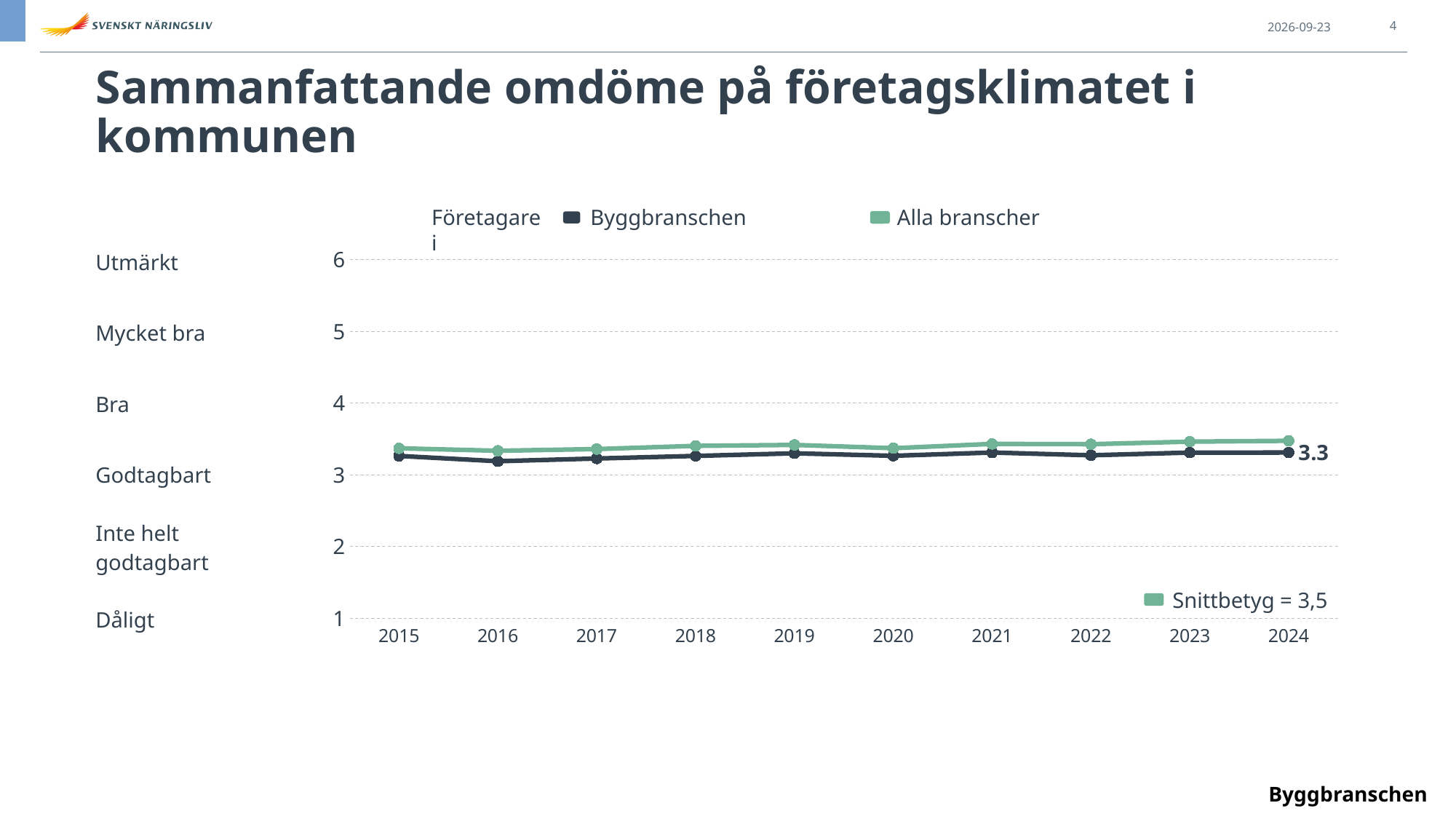
In 2016, which series has the higher value, Byggbranschen or Alla branscher? Alla branscher Is the value for Byggbranschen in 2024 greater or less than 3? greater What is the value of the Byggbranschen series in 2024? 3.3 How many years are shown on the x axis of the chart? 10 How many series does the chart legend list? 2 In 2024, which series has the higher value, Byggbranschen or Alla branscher? Alla branscher What is the Snittbetyg value shown on the chart? 3,5 Is the value for Alla branscher in 2015 greater or less than 4? less Which rating label corresponds to the value 3 on the y axis? Godtagbart What is the first year shown on the x axis? 2015 What kind of chart is shown on the slide? line chart Is the value for Byggbranschen in 2016 greater or less than 4? less